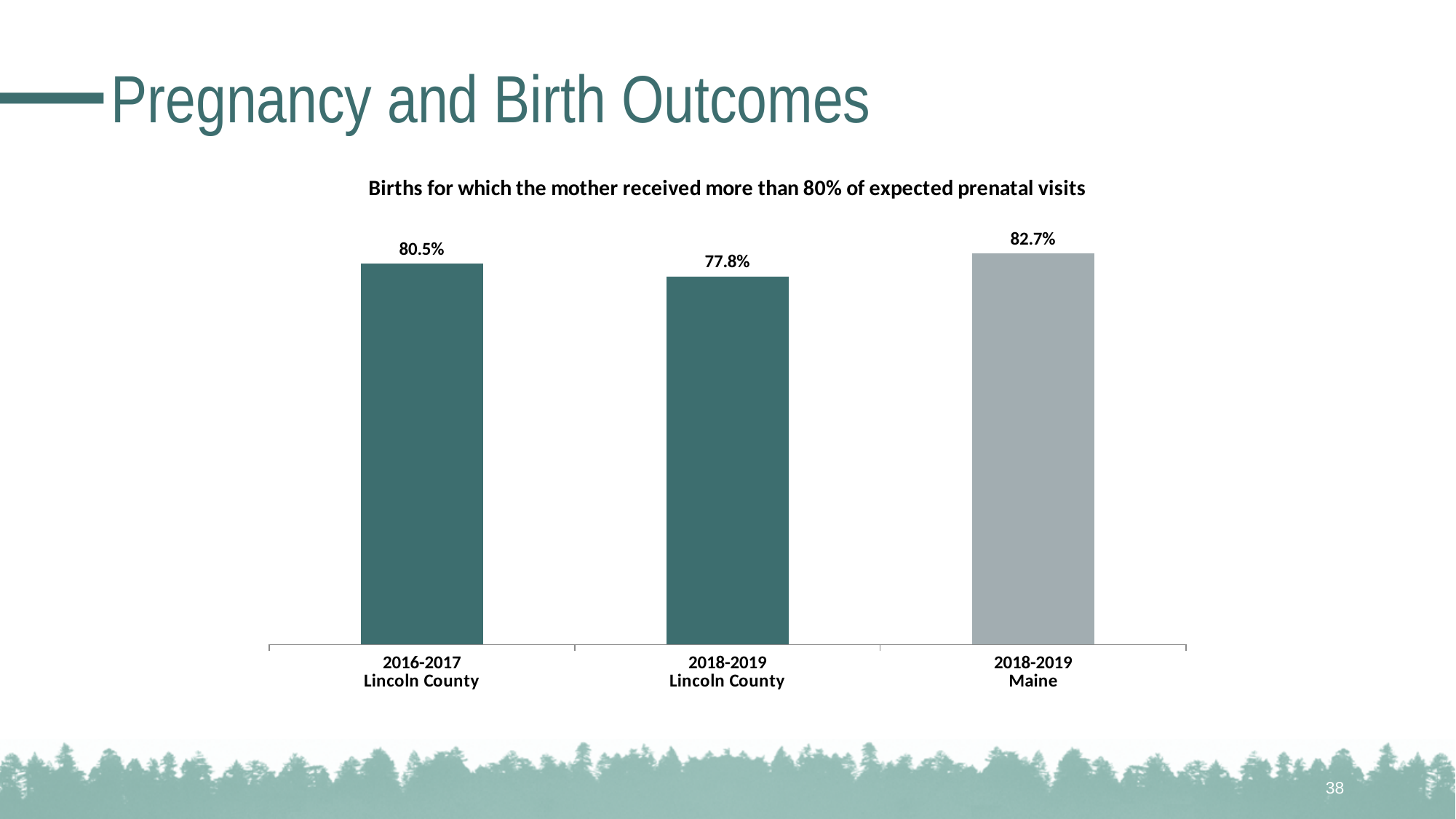
Which is larger, the value for 2016-2017 Lincoln County or the value for 2018-2019 Lincoln County? 2016-2017 Lincoln County How many bars are shown in the chart? 3 What is the value for 2018-2019 Maine? 82.7% What is the title of the chart? Births for which the mother received more than 80% of expected prenatal visits What is the difference between the 2016-2017 Lincoln County value and the 2018-2019 Lincoln County value? 2.7% Which category has the lowest value? 2018-2019 Lincoln County What is the value for 2018-2019 Lincoln County? 77.8% Which category has the highest value? 2018-2019 Maine Did the Lincoln County value rise or fall from 2016-2017 to 2018-2019? Fall What kind of chart is shown on the slide? Bar chart What is the value for 2016-2017 Lincoln County? 80.5% What is the difference between the 2018-2019 Maine value and the 2018-2019 Lincoln County value? 4.9%